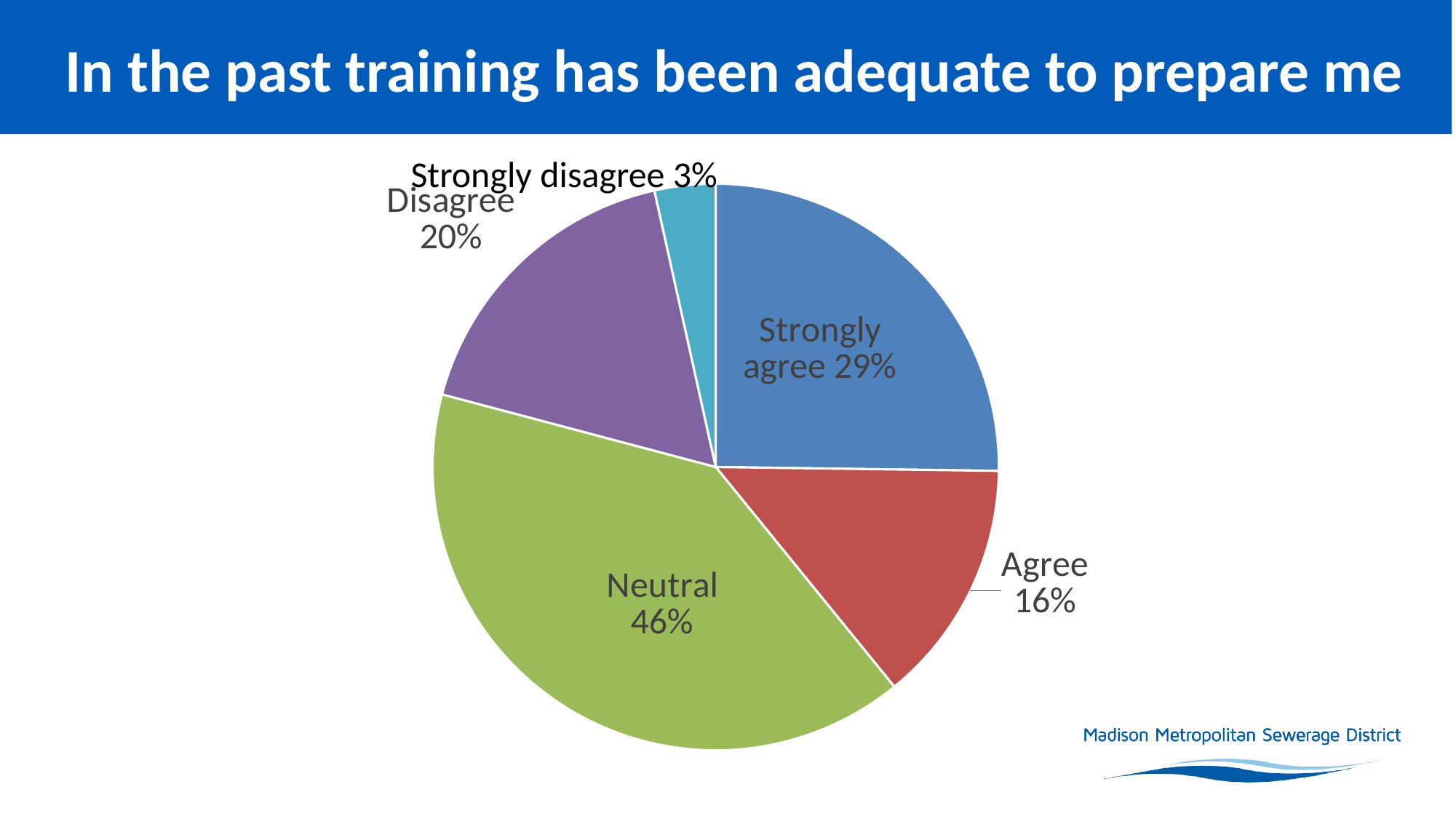
Which category has the smallest slice of the pie? Strongly disagree What percentage is shown for Strongly disagree? 3% What percentage is shown for Strongly agree? 29% Which is larger, the Disagree slice or the Agree slice? Disagree Which category has the largest slice of the pie? Neutral What is the difference in percentage points between Neutral and Strongly agree? 17 What percentage is shown for Agree? 16% What percentage is shown for Disagree? 20% How many slices does the pie chart have? 5 What share of the pie is labelled Neutral? 46% What kind of chart is shown on the slide? pie chart What is the title of the slide containing the pie chart? In the past training has been adequate to prepare me